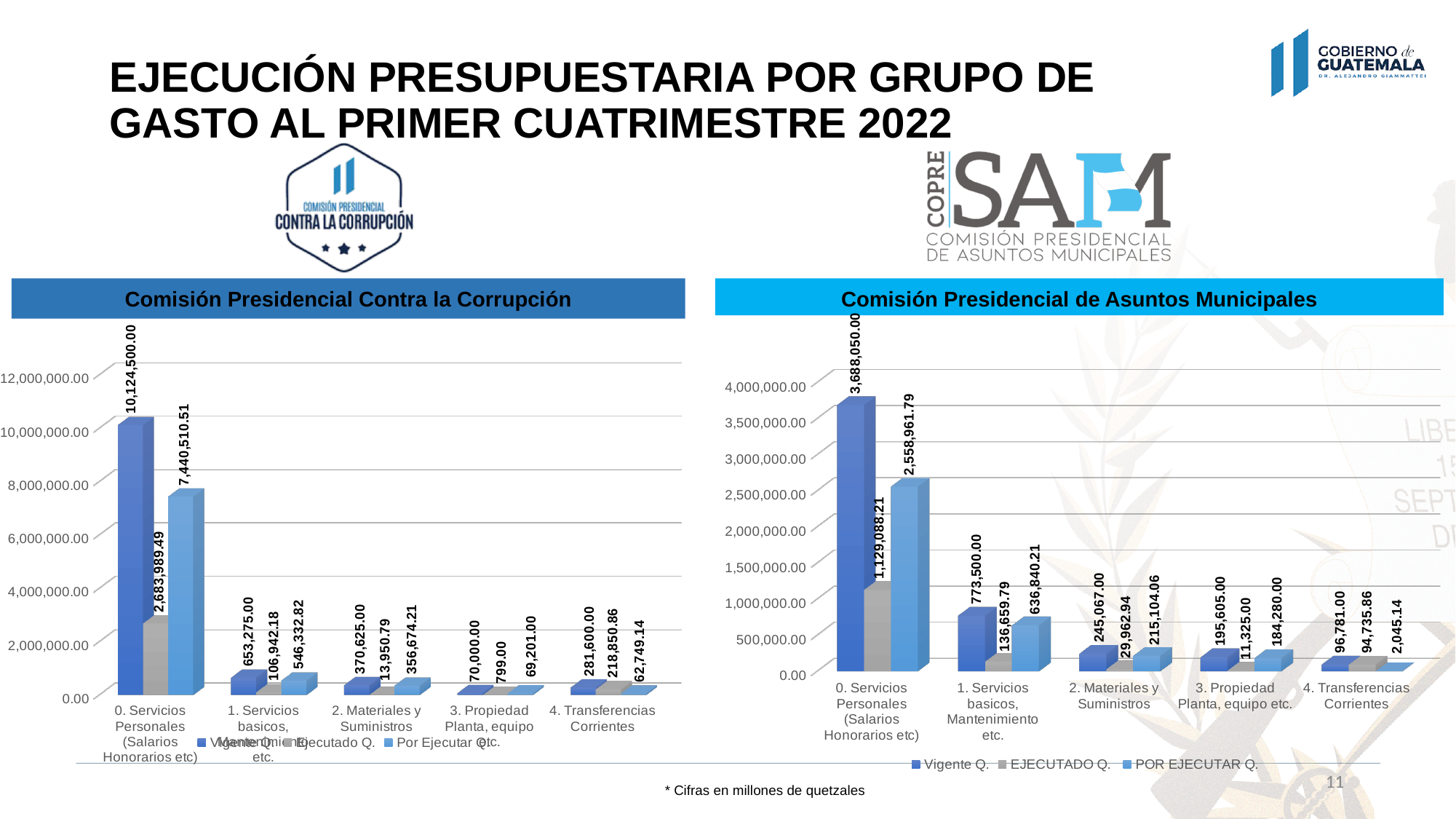
What type of chart is the Comisión Presidencial Contra la Corrupción chart? Bar chart In the Comisión Presidencial Contra la Corrupción chart, how many categories are shown on the x axis? 5 In the Comisión Presidencial de Asuntos Municipales chart, what is the Por Ejecutar Q. value for 0. Servicios Personales (Salarios Honorarios etc)? 2,558,961.79 In the Comisión Presidencial de Asuntos Municipales chart, which category has the highest Vigente Q. value? 0. Servicios Personales (Salarios Honorarios etc) In the Comisión Presidencial Contra la Corrupción chart, which category has the lowest Ejecutado Q. value? 3. Propiedad Planta, equipo etc. In the Comisión Presidencial Contra la Corrupción chart, what is the Vigente Q. value for 0. Servicios Personales (Salarios Honorarios etc)? 10,124,500.00 How many series does the legend of the Comisión Presidencial de Asuntos Municipales chart list? 3 In the Comisión Presidencial Contra la Corrupción chart, what is the difference between the Vigente Q. and Ejecutado Q. values for 1. Servicios basicos, Mantenimiento etc.? 546,332.82 In the Comisión Presidencial de Asuntos Municipales chart, what is the EJECUTADO Q. value for 2. Materiales y Suministros? 29,962.94 In the Comisión Presidencial de Asuntos Municipales chart, is the EJECUTADO Q. value for 4. Transferencias Corrientes larger or smaller than the POR EJECUTAR Q. value for the same category? larger In the Comisión Presidencial de Asuntos Municipales chart, is the Vigente Q. value for 1. Servicios basicos, Mantenimiento etc. greater or less than 1,000,000.00? less In the Comisión Presidencial Contra la Corrupción chart, what is the Ejecutado Q. value for 4. Transferencias Corrientes? 218,850.86